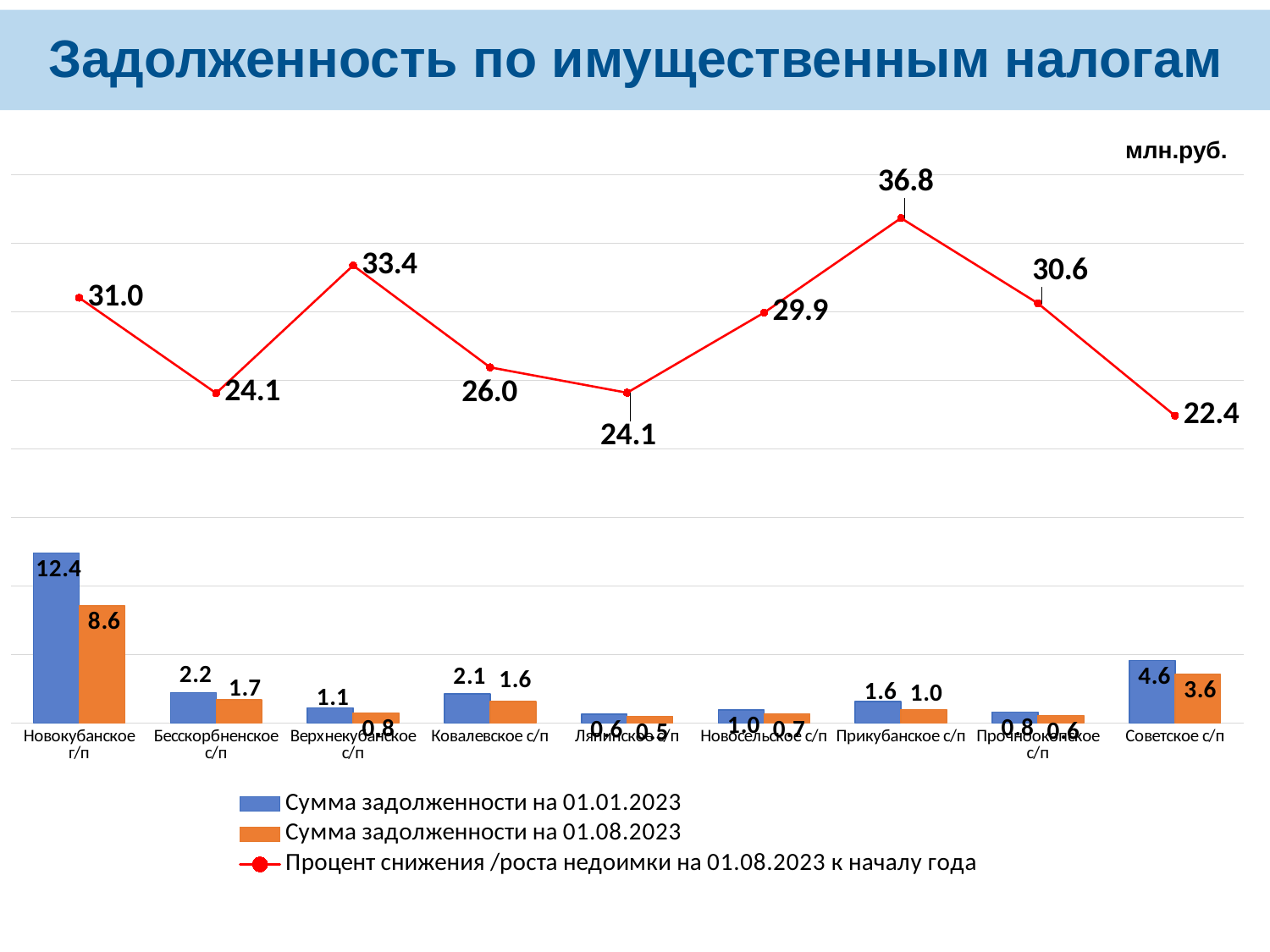
Which is larger for Ковалевское с/п: the Сумма задолженности на 01.01.2023 or на 01.08.2023? Сумма задолженности на 01.01.2023 What unit is indicated in the top right corner of the chart? млн.руб. Which category has the highest value on the line series (Процент снижения /роста недоимки)? Прикубанское с/п What is the value of the line series (Процент снижения /роста недоимки на 01.08.2023 к началу года) for Прикубанское с/п? 36.8 Which category has the highest Сумма задолженности на 01.01.2023? Новокубанское г/п What is the Сумма задолженности на 01.01.2023 for Новокубанское г/п? 12.4 What is the title of the slide's chart? Задолженность по имущественным налогам What is the Сумма задолженности на 01.08.2023 for Советское с/п? 3.6 How many series does the legend list? 3 Which category has the lowest value on the line series (Процент снижения /роста недоимки)? Советское с/п How many categories (settlements) are shown on the x axis? 9 What is the difference between the Сумма задолженности на 01.01.2023 and на 01.08.2023 for Новокубанское г/п? 3.8